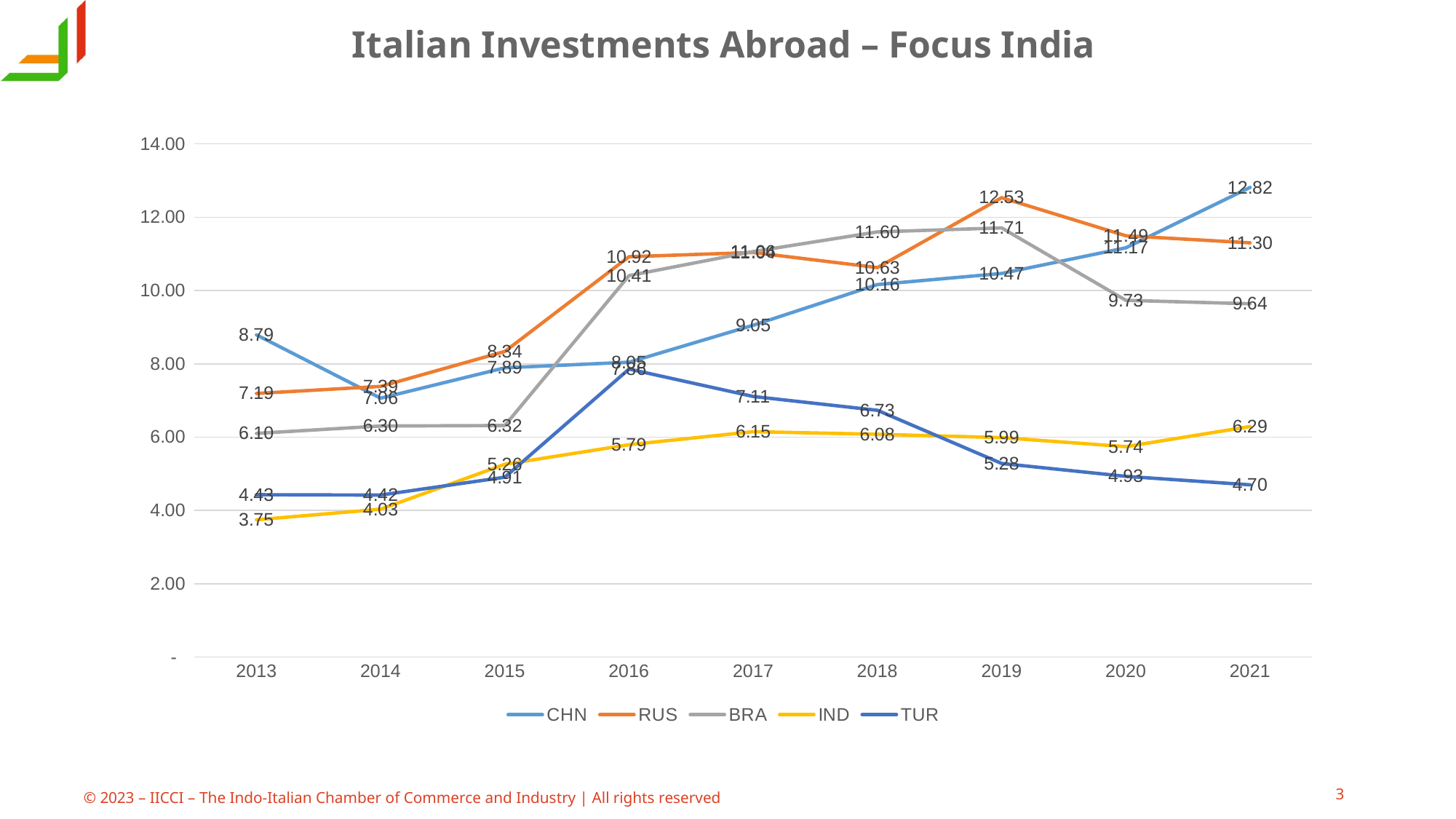
What is the value for RUS in 2019? 12.53 What is the value for CHN in 2013? 8.79 In which year is the IND series at its lowest? 2013 How many series does the legend list? 5 In 2019, which is larger: the BRA value or the CHN value? BRA What is the difference between the CHN and RUS values in 2021? 1.52 What is the value for BRA in 2020? 9.73 What is the value for IND in 2021? 6.29 Is the value for BRA in 2017 greater or less than 10.00? greater What kind of chart is shown on the slide? Line chart What is the value for TUR in 2018? 6.73 In which year does the CHN series reach its highest value? 2021